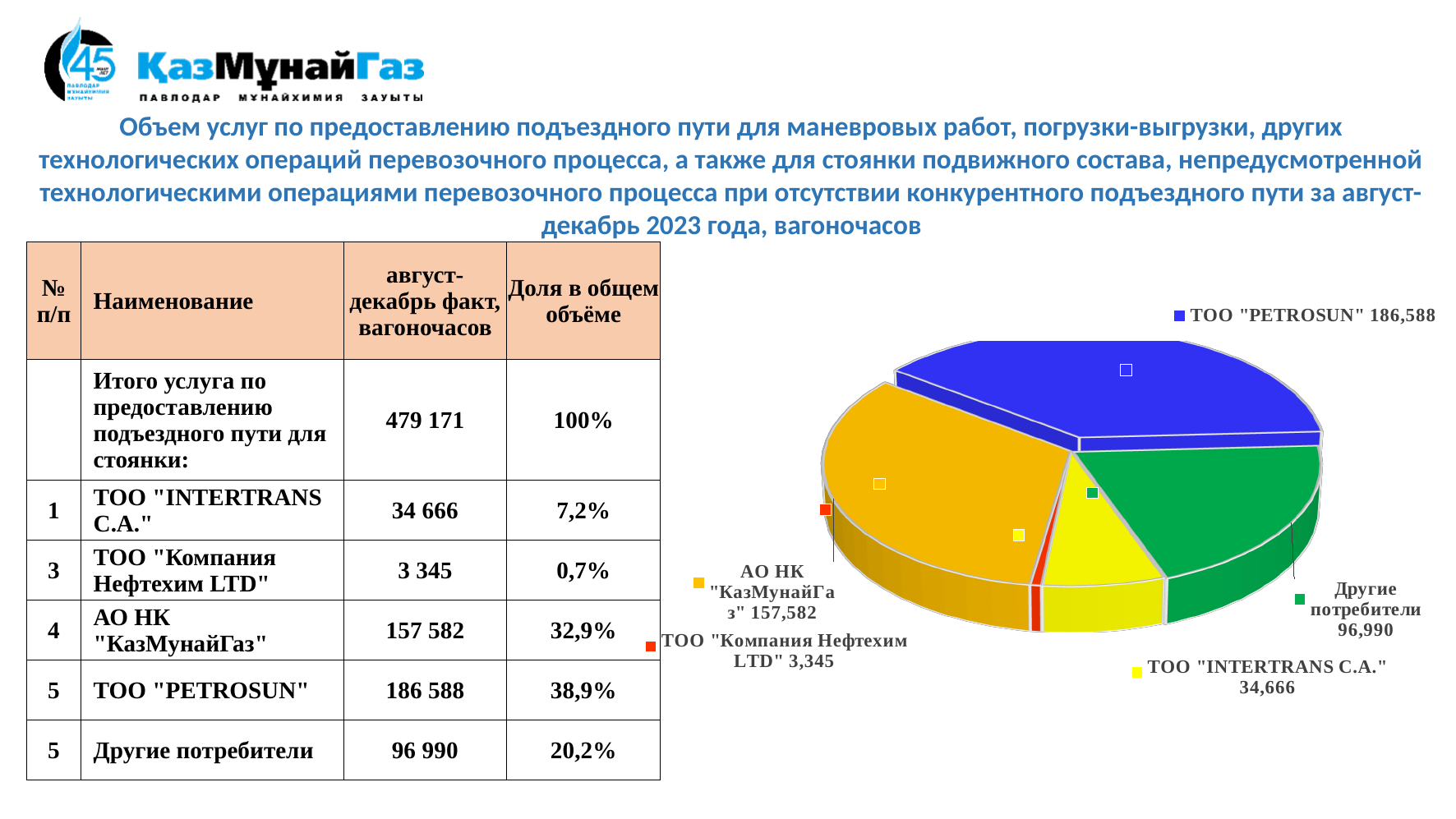
What share of the total does ТОО "PETROSUN" represent, according to the slide? 38,9% What is the difference between the values for ТОО "PETROSUN" and АО НК "КазМунайГаз" in the pie chart? 29,006 How many slices does the pie chart have? 5 What is the value shown for ТОО "Компания Нефтехим LTD" in the pie chart? 3,345 What is the value shown for АО НК "КазМунайГаз" in the pie chart? 157,582 Which category has the smallest slice in the pie chart? ТОО "Компания Нефтехим LTD" Which category has the largest slice in the pie chart? ТОО "PETROSUN" Which is larger in the pie chart: Другие потребители or ТОО "INTERTRANS C.A."? Другие потребители What is the value shown for ТОО "PETROSUN" in the pie chart? 186,588 What type of chart is shown on the slide? pie chart What colour is the slice for АО НК "КазМунайГаз" in the pie chart? orange What is the value shown for Другие потребители in the pie chart? 96,990